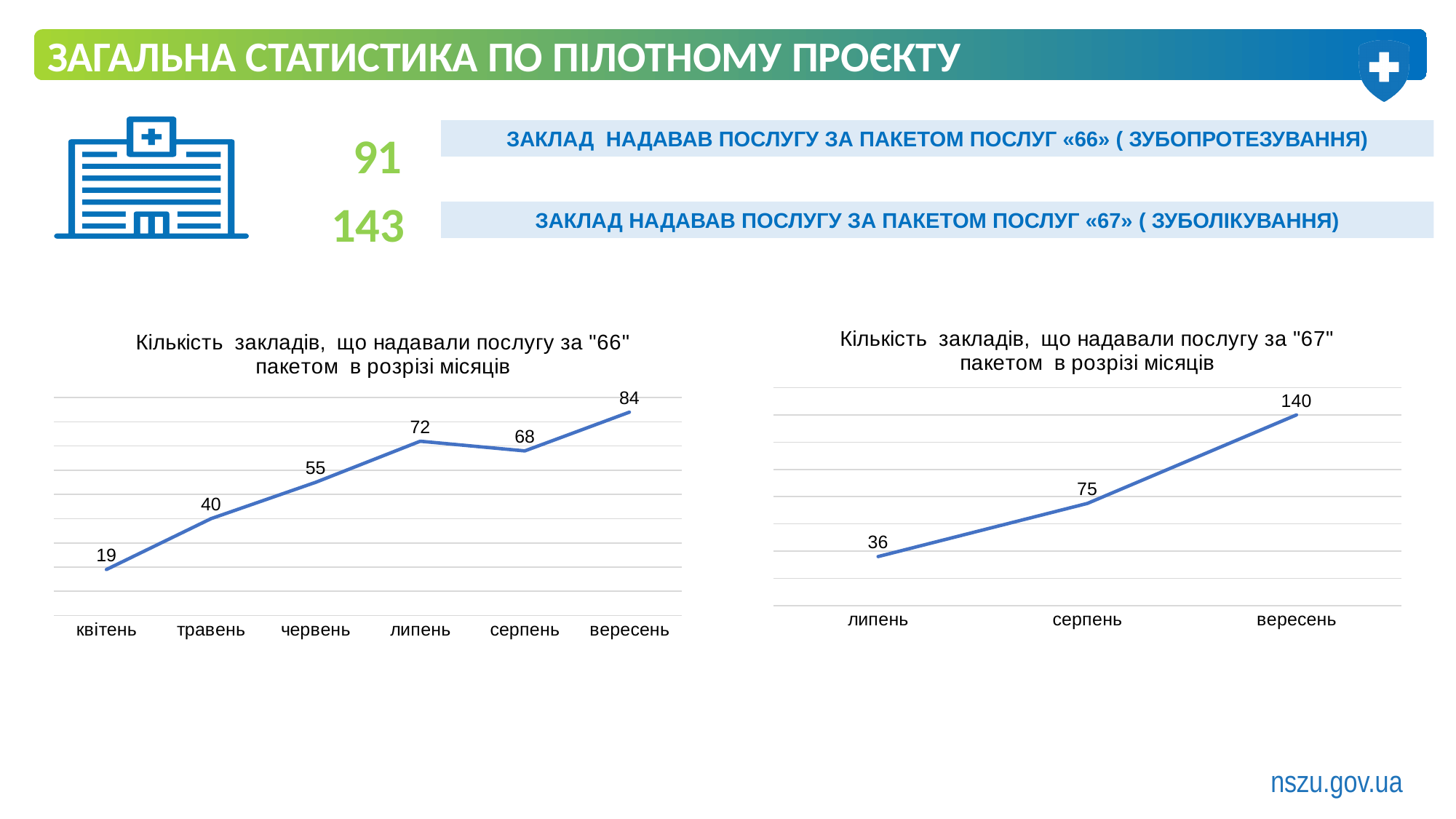
In the right chart (package "67"), what is the value for серпень? 75 In the right chart (package "67"), which month has the lowest value? липень In the left chart (package "66"), what is the value for липень? 72 In the left chart (package "66"), which is larger, the value for липень or the value for серпень? липень How many months are plotted in the right chart (package "67")? 3 In the right chart (package "67"), do the values rise or fall from липень to вересень? rise In the left chart (package "66"), what is the value for квітень? 19 In the right chart (package "67"), what is the difference between the values for вересень and липень? 104 What type of chart is the right chart (package "67")? line chart In the left chart (package "66"), which month has the highest value? вересень How many months are plotted in the left chart (package "66")? 6 In the left chart (package "66"), what is the difference between the values for вересень and серпень? 16